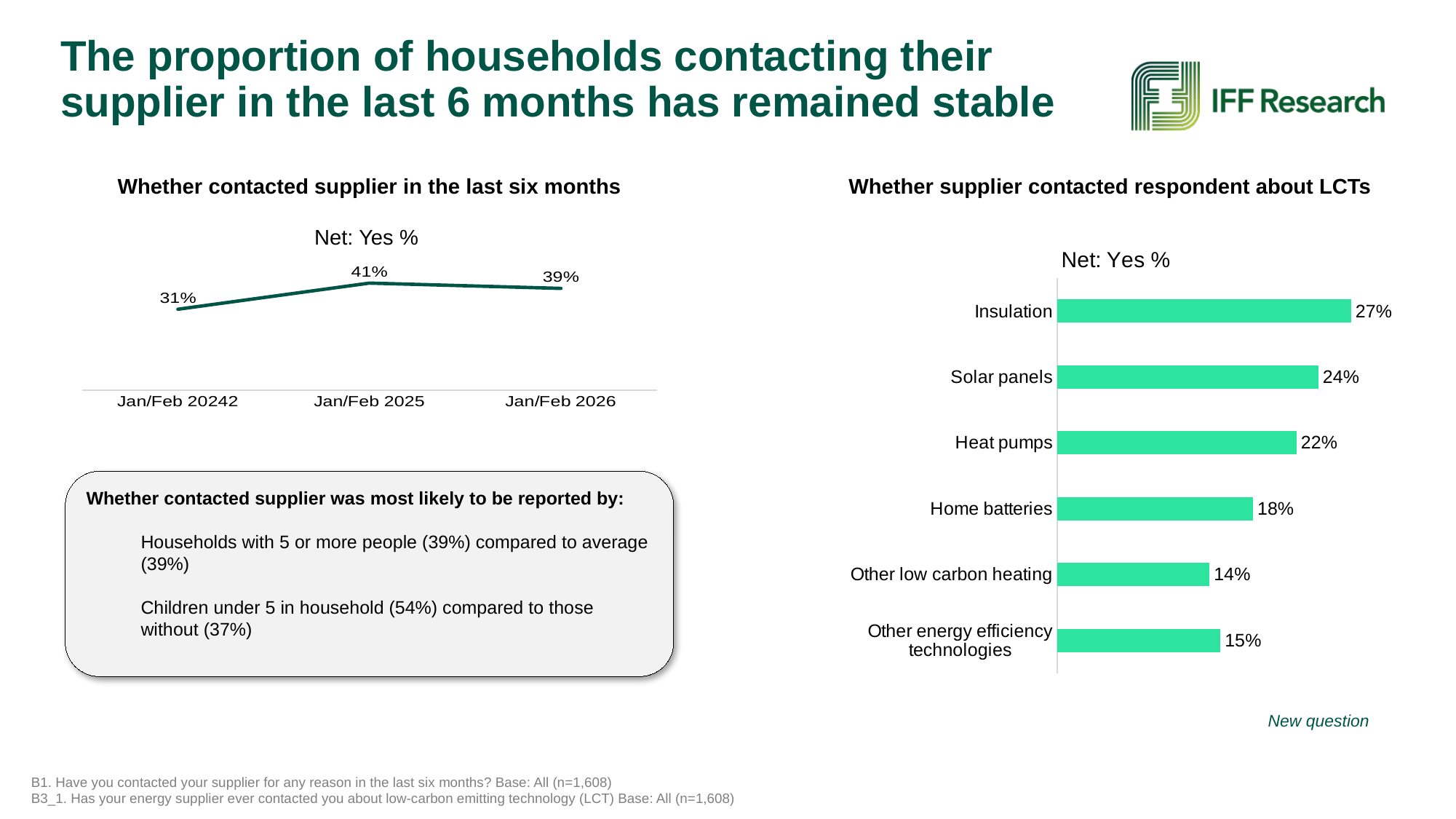
In the 'Whether contacted supplier in the last six months' chart, how many data points are plotted? 3 In the 'Whether contacted supplier in the last six months' chart, what is the difference between the Jan/Feb 2025 and Jan/Feb 2026 values? 2 percentage points How many categories are shown in the 'Whether supplier contacted respondent about LCTs' chart? 6 In the 'Whether supplier contacted respondent about LCTs' chart, what is the value for Heat pumps? 22% In the 'Whether supplier contacted respondent about LCTs' chart, which category has the highest value? Insulation In the 'Whether supplier contacted respondent about LCTs' chart, which is larger: Solar panels or Other energy efficiency technologies? Solar panels In the 'Whether contacted supplier in the last six months' chart, what is the value for Jan/Feb 2026? 39% What kind of chart is 'Whether contacted supplier in the last six months'? Line chart In the 'Whether contacted supplier in the last six months' chart, which period has the lowest value? Jan/Feb 20242 In the 'Whether supplier contacted respondent about LCTs' chart, which category has the lowest value? Other low carbon heating In the 'Whether supplier contacted respondent about LCTs' chart, what is the difference between Insulation and Home batteries? 9 percentage points In the 'Whether contacted supplier in the last six months' chart, what is the value for Jan/Feb 2025? 41%